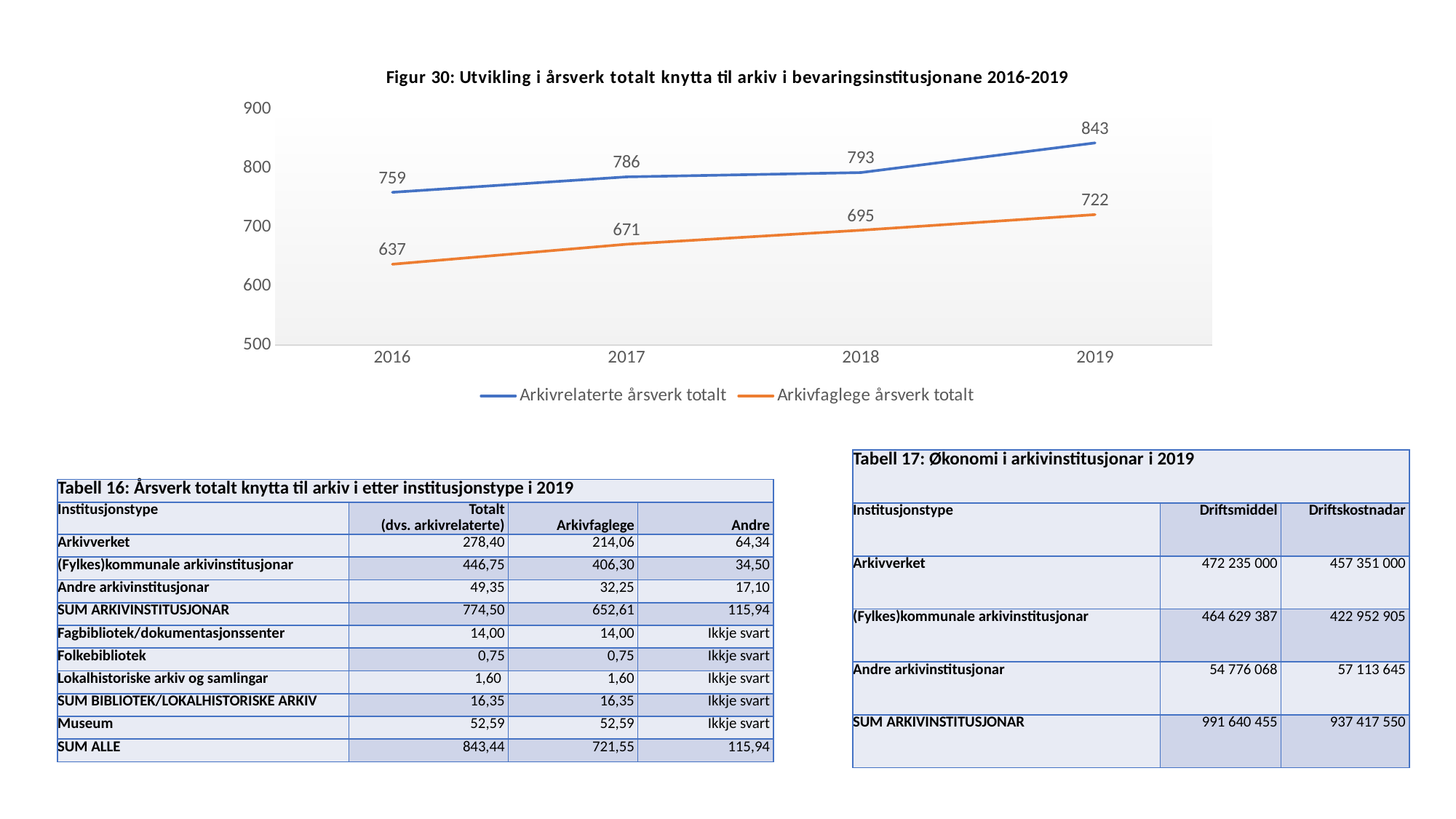
How many series does the legend of Figur 30 list? 2 In Figur 30, how many years are shown on the x axis? 4 In Figur 30, do the values for Arkivfaglege årsverk totalt rise or fall from 2016 to 2019? rise In Figur 30, what is the value of Arkivrelaterte årsverk totalt in 2019? 843 In Figur 30, what is the difference between Arkivrelaterte årsverk totalt and Arkivfaglege årsverk totalt in 2017? 115 In Figur 30, which series has the larger value in 2018, Arkivrelaterte årsverk totalt or Arkivfaglege årsverk totalt? Arkivrelaterte årsverk totalt In Figur 30, what is the value of Arkivfaglege årsverk totalt in 2018? 695 In Figur 30, what is the value of Arkivrelaterte årsverk totalt in 2016? 759 In Figur 30, which year has the highest value for Arkivfaglege årsverk totalt? 2019 In Figur 30, which year has the lowest value for Arkivrelaterte årsverk totalt? 2016 In Figur 30, by how much did Arkivfaglege årsverk totalt increase from 2016 to 2019? 85 What type of chart is Figur 30? line chart